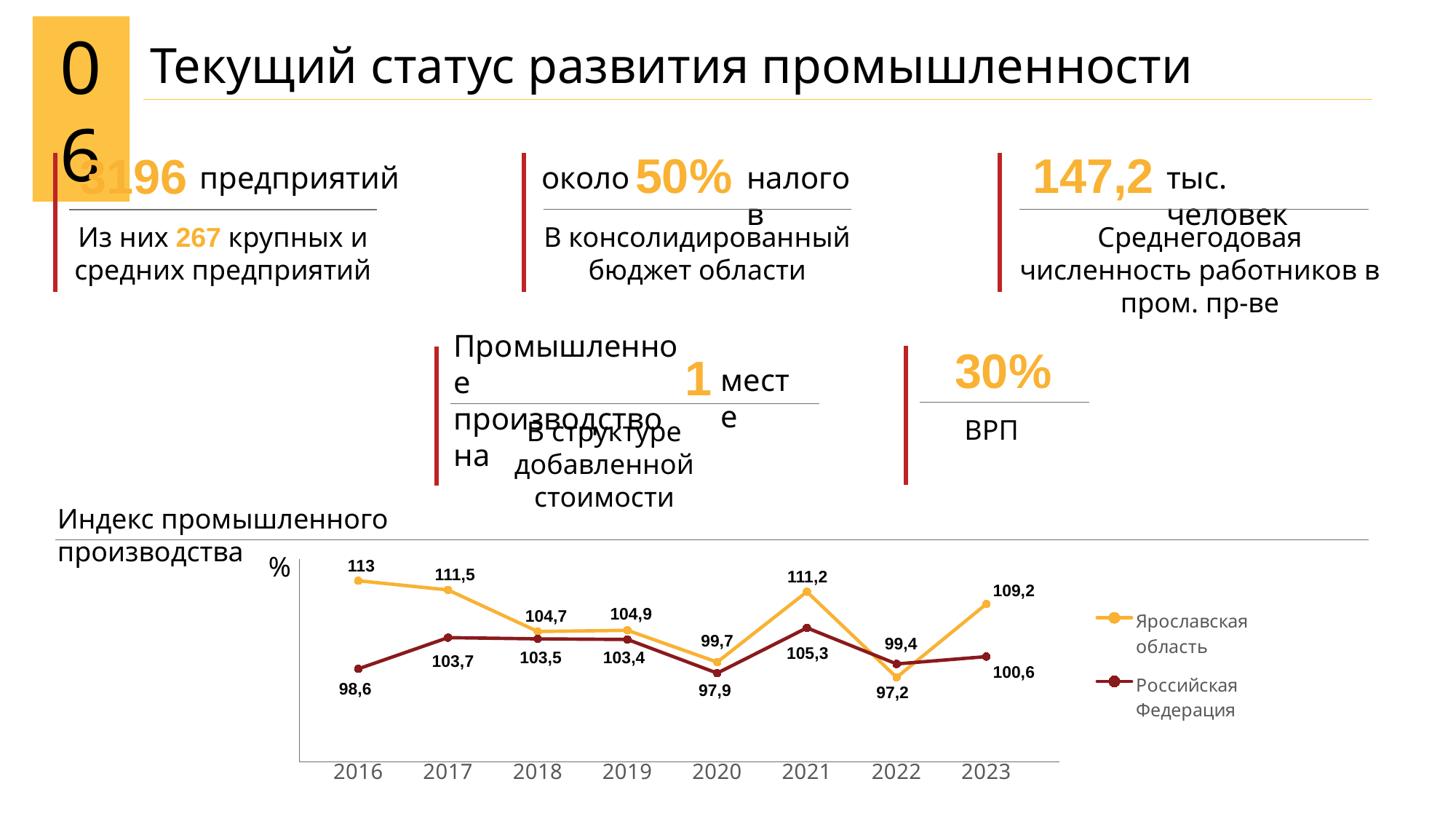
How many years are shown on the x axis? 8 What is the value for Ярославская область in 2016? 113 What is the title of the chart? Индекс промышленного производства How many series does the legend list? 2 What is the value for Ярославская область in 2023? 109,2 Does the value for Российская Федерация rise or fall from 2021 to 2022? fall Which series has the larger value in 2022, Ярославская область or Российская Федерация? Российская Федерация What type of chart is shown on the slide? line chart What is the value for Российская Федерация in 2020? 97,9 In which year is the value for Российская Федерация the lowest? 2020 In which year is the value for Ярославская область the highest? 2016 What is the difference between Ярославская область and Российская Федерация in 2016? 14,4